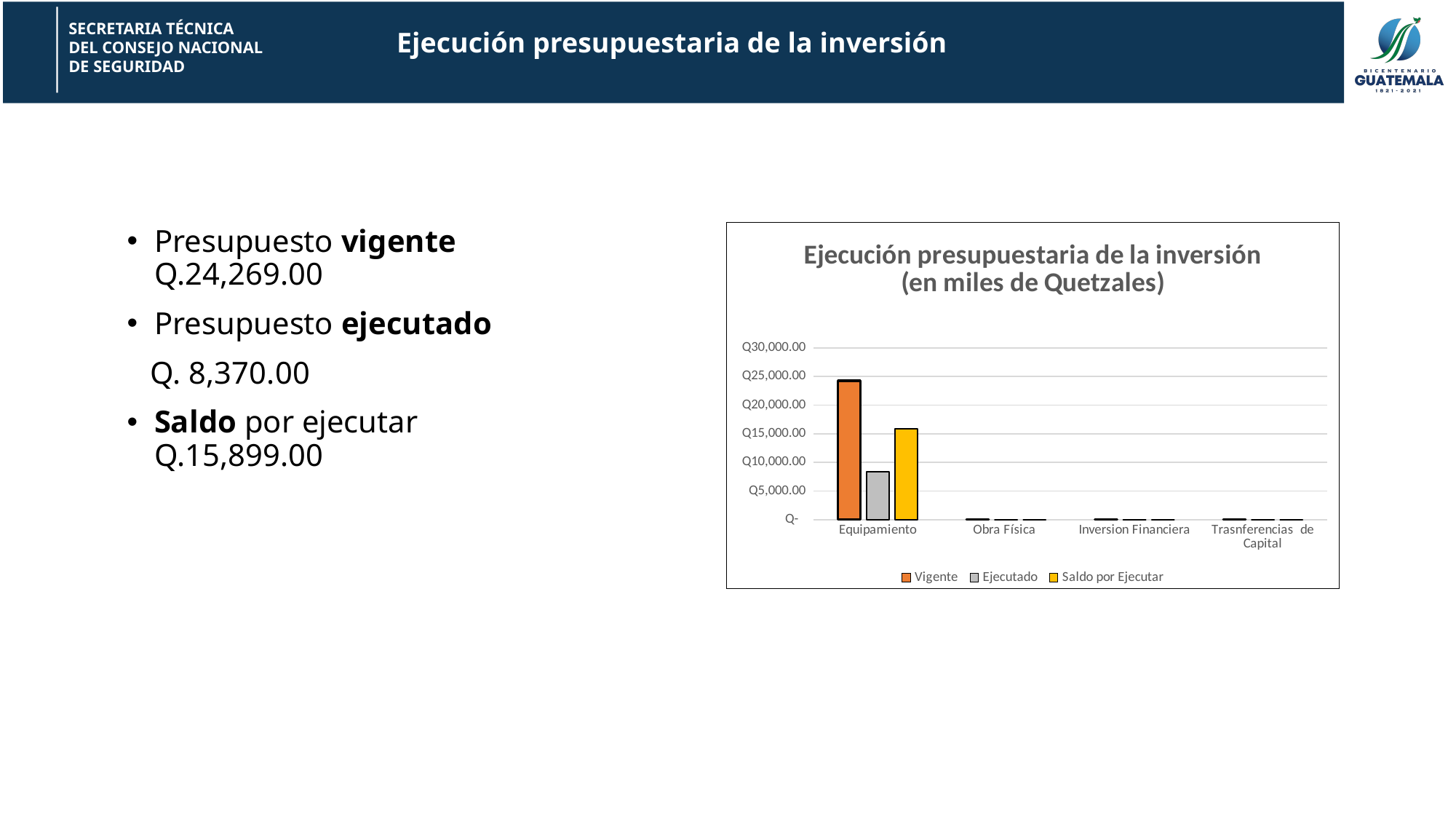
Which series is shown in orange in the chart? Vigente How many categories are shown on the x axis of the chart? 4 Which category has the highest Vigente value? Equipamiento For Equipamiento, which is larger: the Saldo por Ejecutar value or the Ejecutado value? Saldo por Ejecutar What kind of chart is shown on the slide? bar chart Is the Vigente value for Equipamiento greater or less than Q20,000.00? greater Is the Ejecutado value for Equipamiento greater or less than Q10,000.00? less For Equipamiento, which is larger: the Vigente value or the Ejecutado value? Vigente How many series does the chart legend list? 3 Is the Vigente value for Obra Física greater or less than Q5,000.00? less What is the title of the chart? Ejecución presupuestaria de la inversión (en miles de Quetzales)